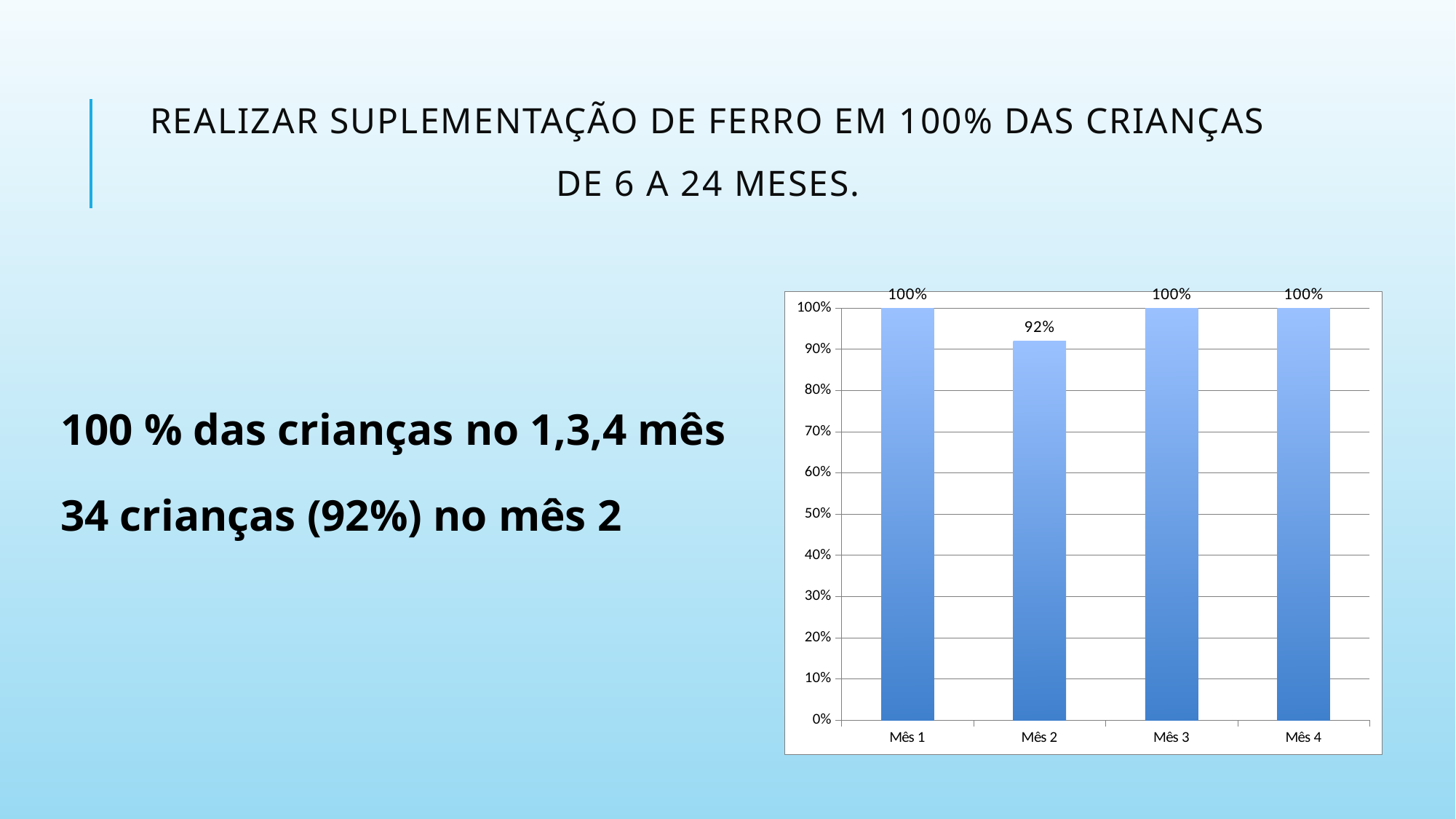
What kind of chart is shown on the slide? bar chart Which is larger, the value for Mês 2 or the value for Mês 3? Mês 3 What is the difference between the values for Mês 1 and Mês 2? 8% What is the value for Mês 2? 92% How many bars reach 100%? 3 Which month has the lowest value? Mês 2 Is the value for Mês 2 greater or less than 90%? greater How many months are shown on the x axis? 4 What is the value for Mês 4? 100% What is the label of the second category on the x axis? Mês 2 What is the highest value shown on the y axis? 100% What is the value for Mês 1? 100%